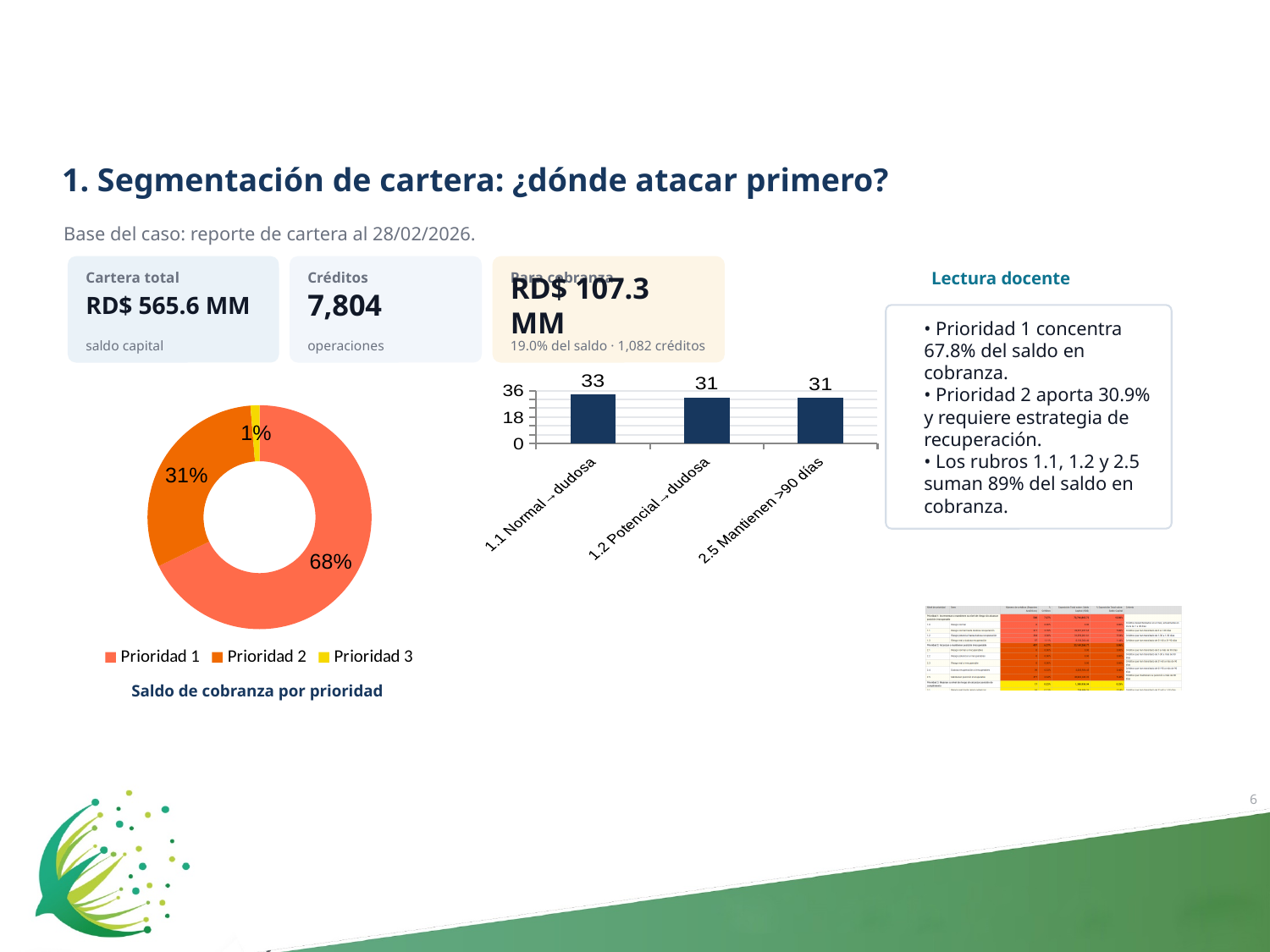
In the bar chart in the middle of the slide, what is the value for '1.1 Normal – dudosa'? 33 In the donut chart 'Saldo de cobranza por prioridad', what share does Prioridad 2 have? 31% In the bar chart in the middle of the slide, which category has the highest value? 1.1 Normal – dudosa In the donut chart 'Saldo de cobranza por prioridad', what share does Prioridad 1 have? 68% In the bar chart in the middle of the slide, how many categories are shown? 3 What kind of chart is the one on the left of the slide, titled 'Saldo de cobranza por prioridad'? Donut (pie) chart In the donut chart 'Saldo de cobranza por prioridad', how many entries does the legend list? 3 In the bar chart in the middle of the slide, what is the value for '2.5 Mantienen >90 días'? 31 In the donut chart 'Saldo de cobranza por prioridad', what share does Prioridad 3 have? 1% In the donut chart 'Saldo de cobranza por prioridad', which priority has the largest share? Prioridad 1 In the donut chart 'Saldo de cobranza por prioridad', which priority has the smallest share? Prioridad 3 In the donut chart 'Saldo de cobranza por prioridad', what is the difference in percentage points between Prioridad 1 and Prioridad 2? 37